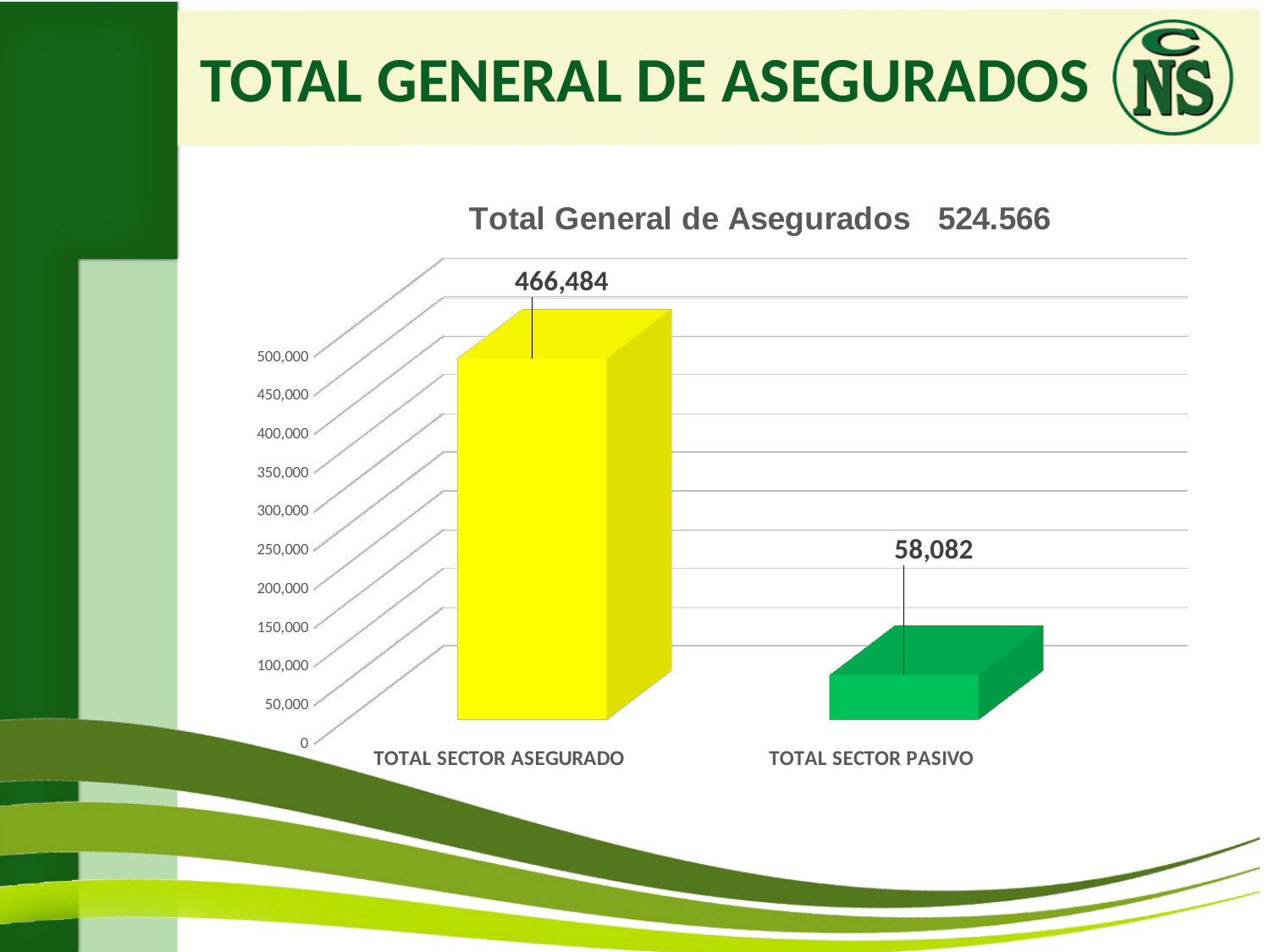
What colour is the bar for TOTAL SECTOR ASEGURADO? yellow What is the title of the chart? Total General de Asegurados 524.566 What is the value for TOTAL SECTOR ASEGURADO? 466,484 How many categories are shown on the x axis of the chart? 2 Which is larger, the value for TOTAL SECTOR ASEGURADO or the value for TOTAL SECTOR PASIVO? TOTAL SECTOR ASEGURADO Which category has the highest value? TOTAL SECTOR ASEGURADO What is the value for TOTAL SECTOR PASIVO? 58,082 Which category has the lowest value? TOTAL SECTOR PASIVO Is the value for TOTAL SECTOR ASEGURADO greater or less than 400,000? greater Is the value for TOTAL SECTOR PASIVO greater or less than 100,000? less What kind of chart is shown on the slide? bar chart What is the difference between the values for TOTAL SECTOR ASEGURADO and TOTAL SECTOR PASIVO? 408,402